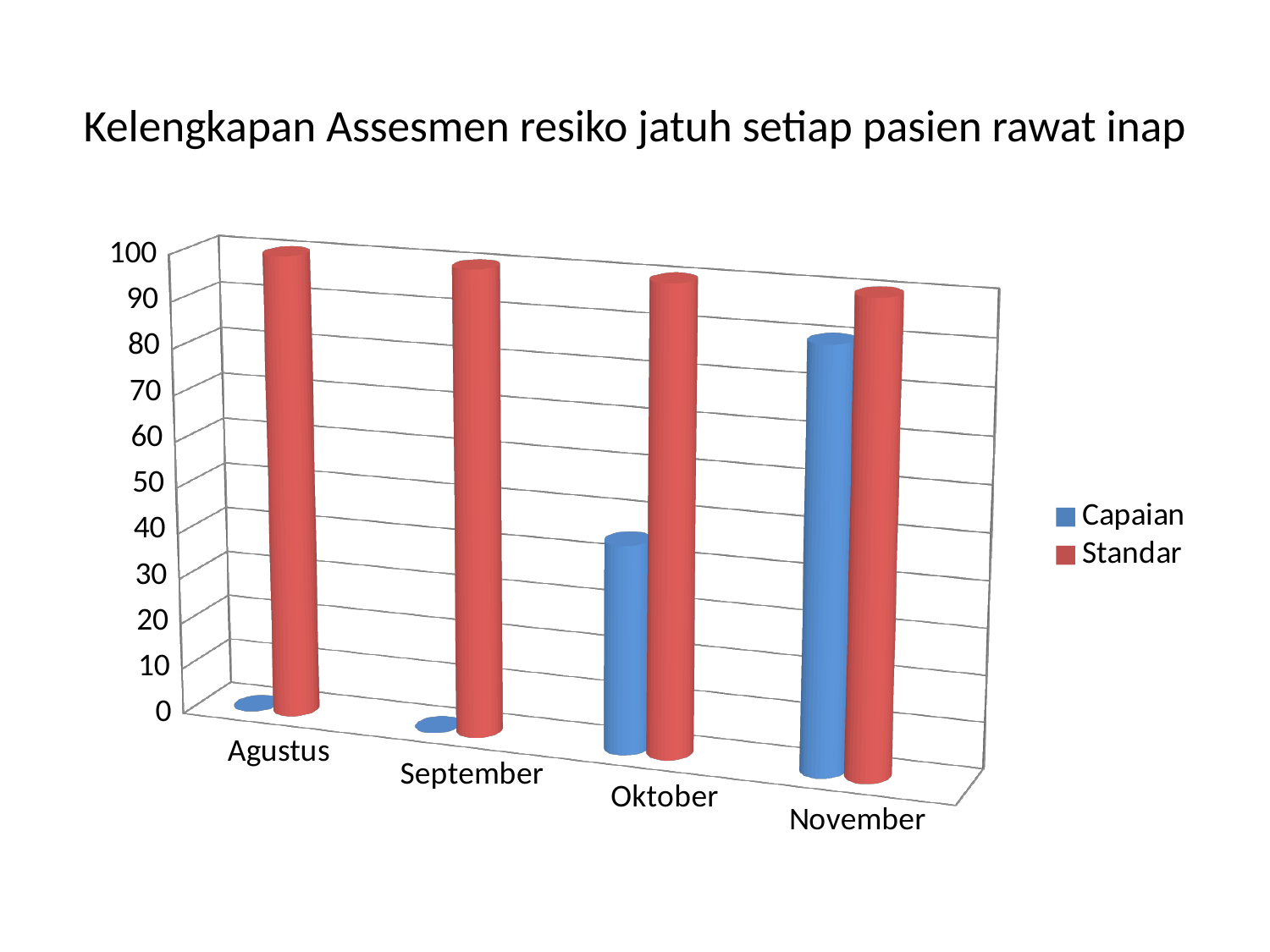
Which is larger in Oktober, Capaian or Standar? Standar Which colour represents the Standar series? Red How many months are shown on the x axis? 4 Which month has the larger Capaian value, Oktober or November? November What is the title of the chart? Kelengkapan Assesmen resiko jatuh setiap pasien rawat inap Is the Standar value for Agustus greater or less than 90? greater Which month has the highest Capaian value? November Do the Capaian values rise or fall from Agustus to November? Rise Is the Capaian value for November greater or less than 50? greater How many series does the legend list? 2 What kind of chart is shown on the slide? Bar chart Is the Capaian value for Oktober greater or less than 50? less